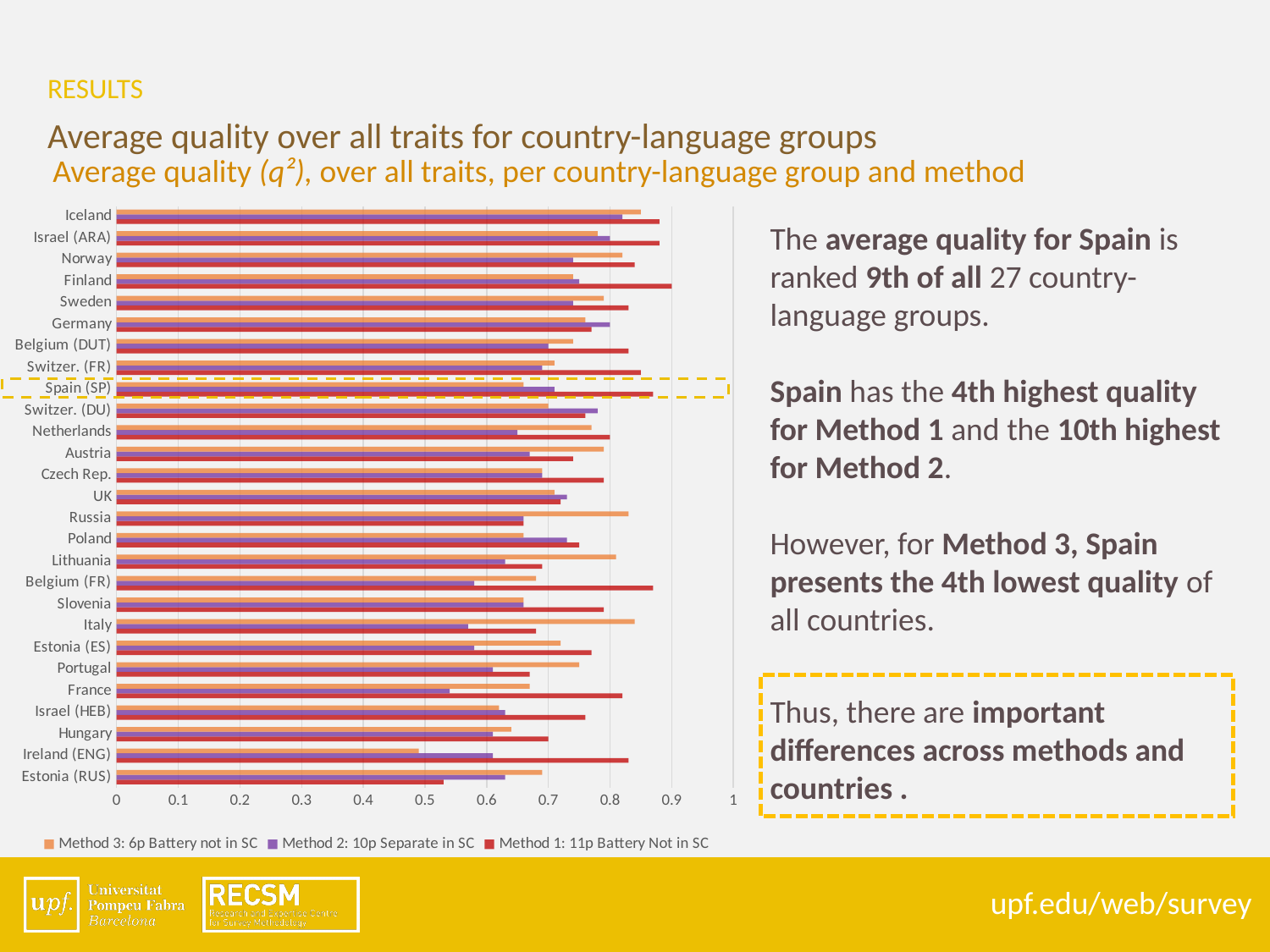
For Ireland (ENG), which method has the lowest value? Method 3: 6p Battery not in SC How many series does the chart's legend list? 3 Is the Method 2 value for France greater or less than 0.6? less Is the Method 3 value for Italy greater or less than 0.8? greater Which is larger: the Method 1 value for Iceland or the Method 1 value for Estonia (RUS)? Iceland Which country-language group appears at the top of the chart? Iceland How many country-language groups are listed on the chart's vertical axis? 27 Is the Method 3 value for Ireland (ENG) greater or less than 0.6? less What is the legend label of the series drawn in dark red? Method 1: 11p Battery Not in SC For Finland, which method has the highest value? Method 1: 11p Battery Not in SC What kind of chart is shown on the slide? bar chart